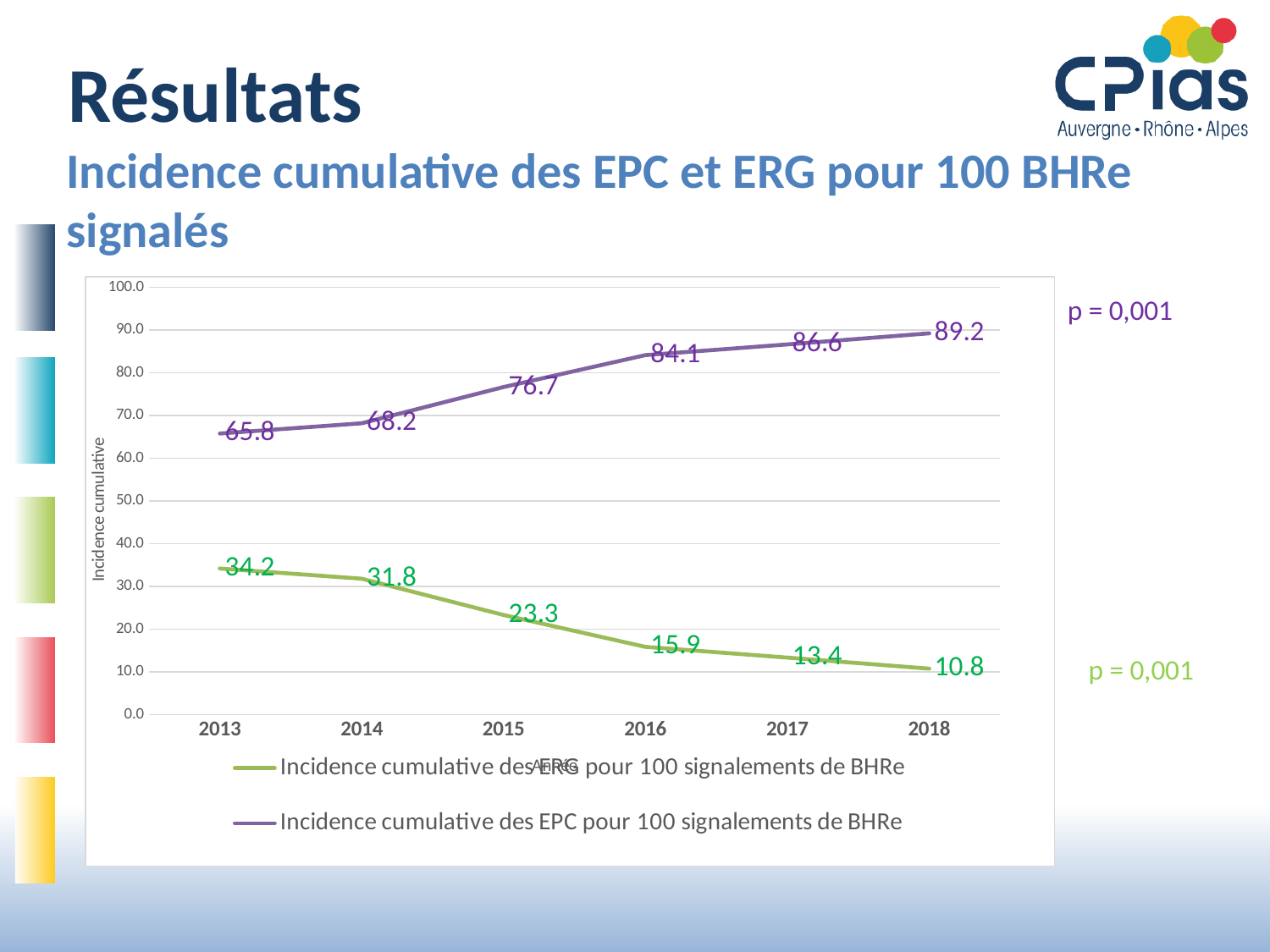
Which is larger in 2014: the EPC value or the ERG value? EPC What is the incidence cumulative des ERG pour 100 signalements de BHRe in 2013? 34.2 Does the ERG series rise or fall from 2013 to 2018? fall What is the difference between the EPC value in 2018 and the EPC value in 2013? 23.4 What is the incidence cumulative des EPC pour 100 signalements de BHRe in 2018? 89.2 What is the value of the EPC series in 2015? 76.7 In which year is the ERG series at its lowest? 2018 How many series does the legend list? 2 In which year is the EPC series at its highest? 2018 What is the value of the ERG series in 2016? 15.9 How many years are shown on the x axis? 6 What kind of chart is shown on the slide? line chart